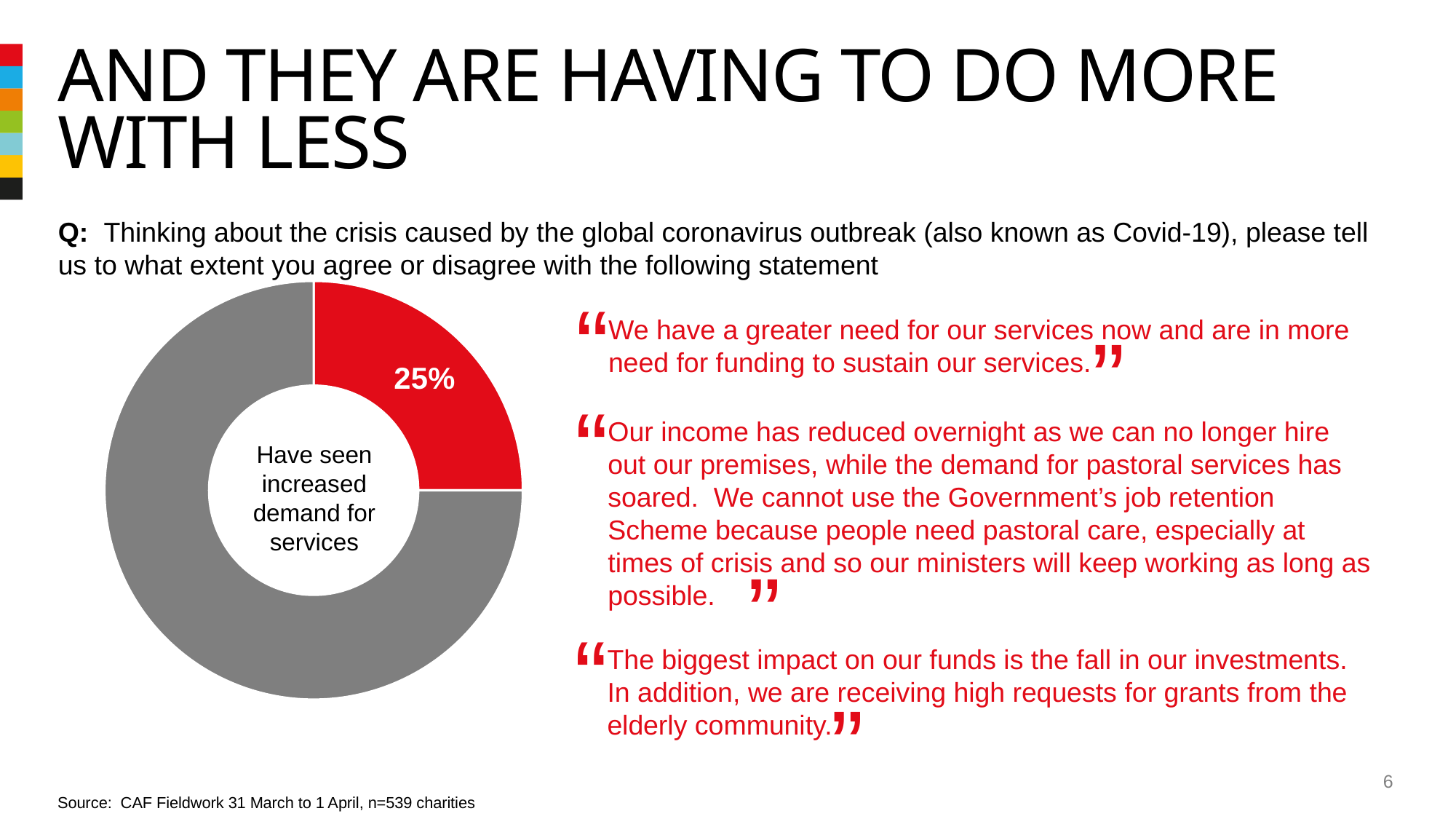
Is the share of charities that have seen increased demand for services greater or less than 50%? less Which slice of the chart is larger, the red slice or the grey slice? The grey slice What colour is the slice labelled 25%? Red What share of the pie does the red slice represent? 25% What text appears in the centre of the donut chart? Have seen increased demand for services What percentage of charities have seen increased demand for services, according to the chart? 25% What kind of chart is shown on the slide? Pie chart (donut) How many slices does the donut chart have? 2